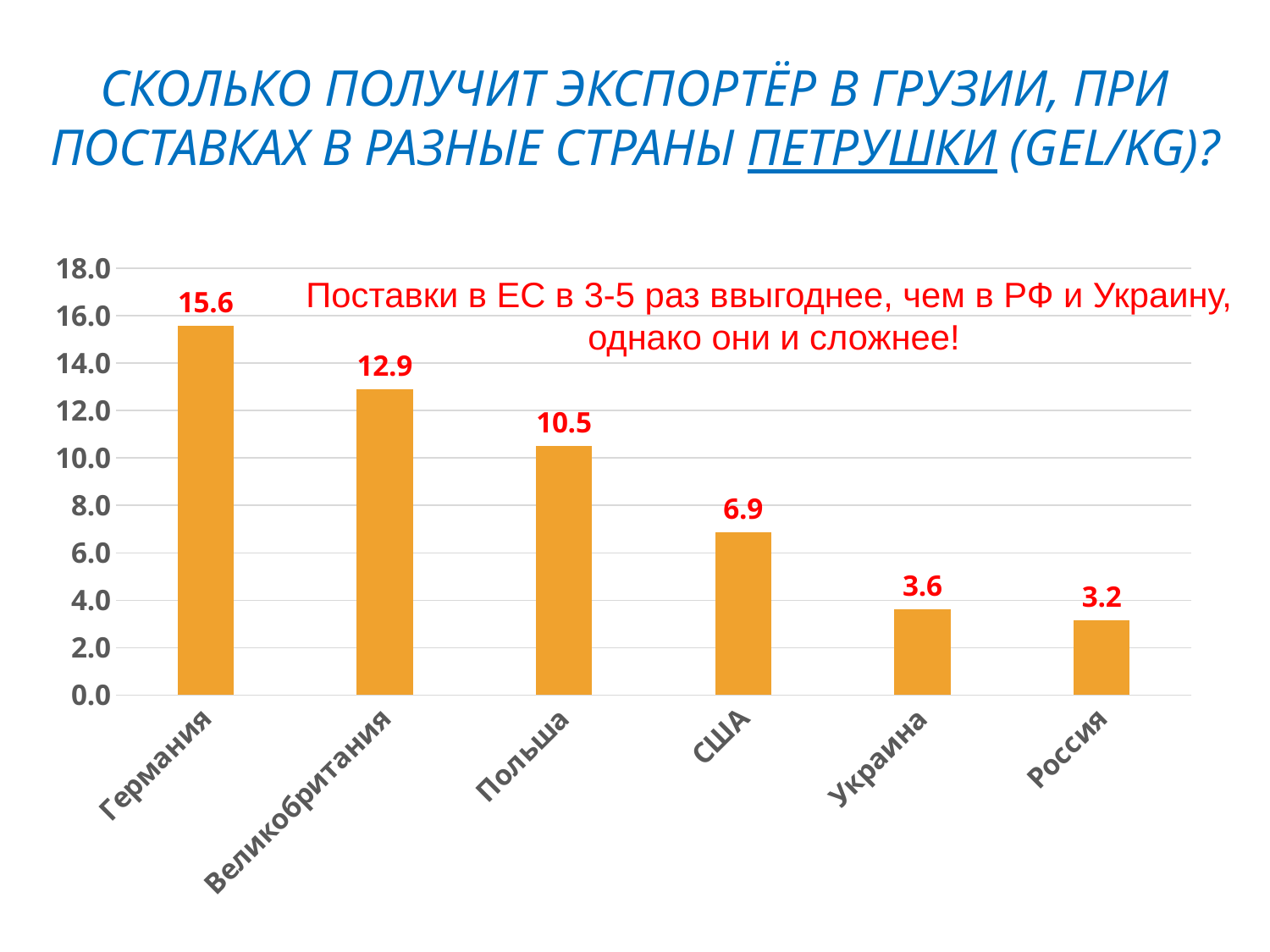
What value is shown for США? 6.9 Which country has the lowest value? Россия Which is larger, the value for Польша or the value for США? Польша Which country has the highest value? Германия Do the values rise or fall from left to right along the x axis? Fall What is the difference between the values for Украина and Россия? 0.4 What value is shown for Германия? 15.6 How many countries are shown on the chart? 6 What is the difference between the values for Германия and Великобритания? 2.7 What kind of chart is this? Bar chart What value is shown for Россия? 3.2 What value is shown for Польша? 10.5